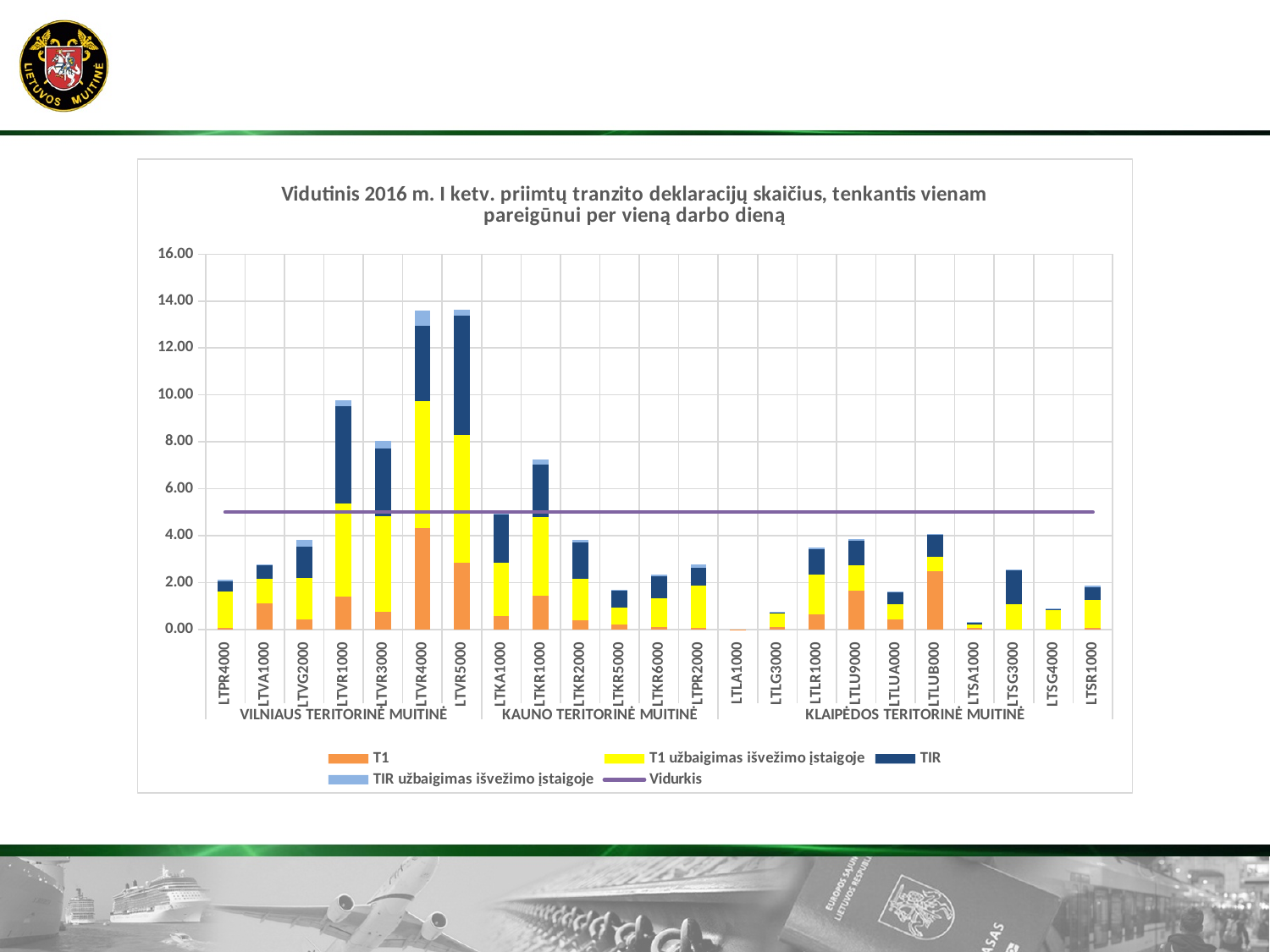
What kind of chart is shown on the slide? Stacked bar chart Which has the larger total bar, LTKR1000 or LTKA1000? LTKR1000 Which category has the lowest total bar? LTLA1000 How many customs post categories are plotted along the x axis? 23 Which has the larger total bar, LTVR1000 or LTVR3000? LTVR1000 Which legend entry is drawn as a horizontal line rather than a bar segment? Vidurkis Is the total value for LTKR1000 greater or less than 6.00? greater Is the total value for LTVR1000 greater or less than 8.00? greater Into how many territorial customs groups are the categories divided on the x axis? 3 Is the total value for LTKA1000 greater or less than 6.00? less How many series does the legend list? 5